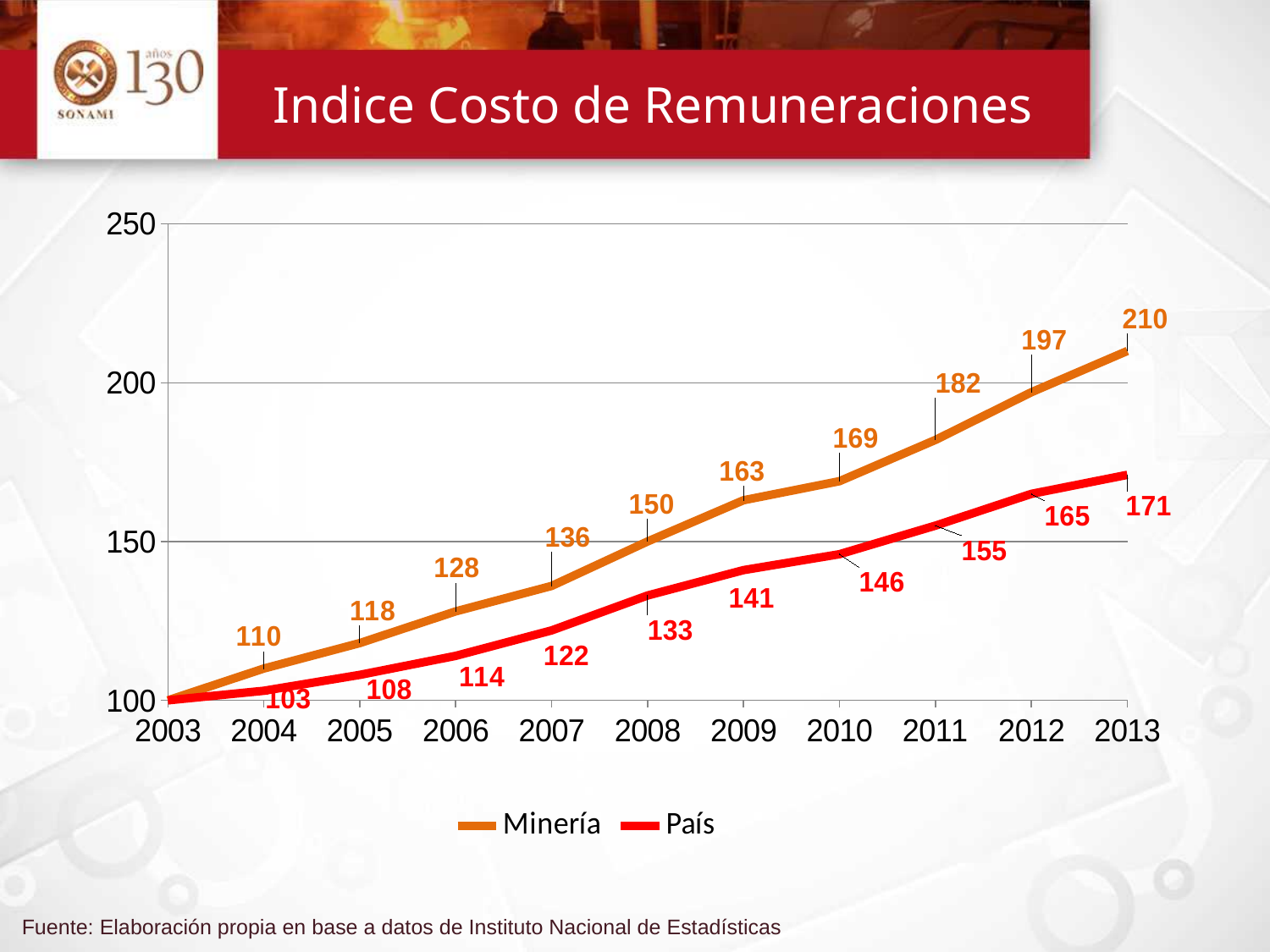
What is the value of the País series in 2008? 133 What is the difference between the Minería values in 2012 and 2011? 15 What is the value of the Minería series in 2013? 210 What is the value of the Minería series in 2009? 163 Which series has the larger value in 2010, Minería or País? Minería Is the value of the Minería series in 2003 greater or less than 150? less How many years are shown on the x axis? 11 How many series does the legend list? 2 What is the difference between the Minería and País values in 2013? 39 What kind of chart is shown on the slide? line chart In which year does the Minería series reach its highest labelled value? 2013 What is the value of the País series in 2012? 165